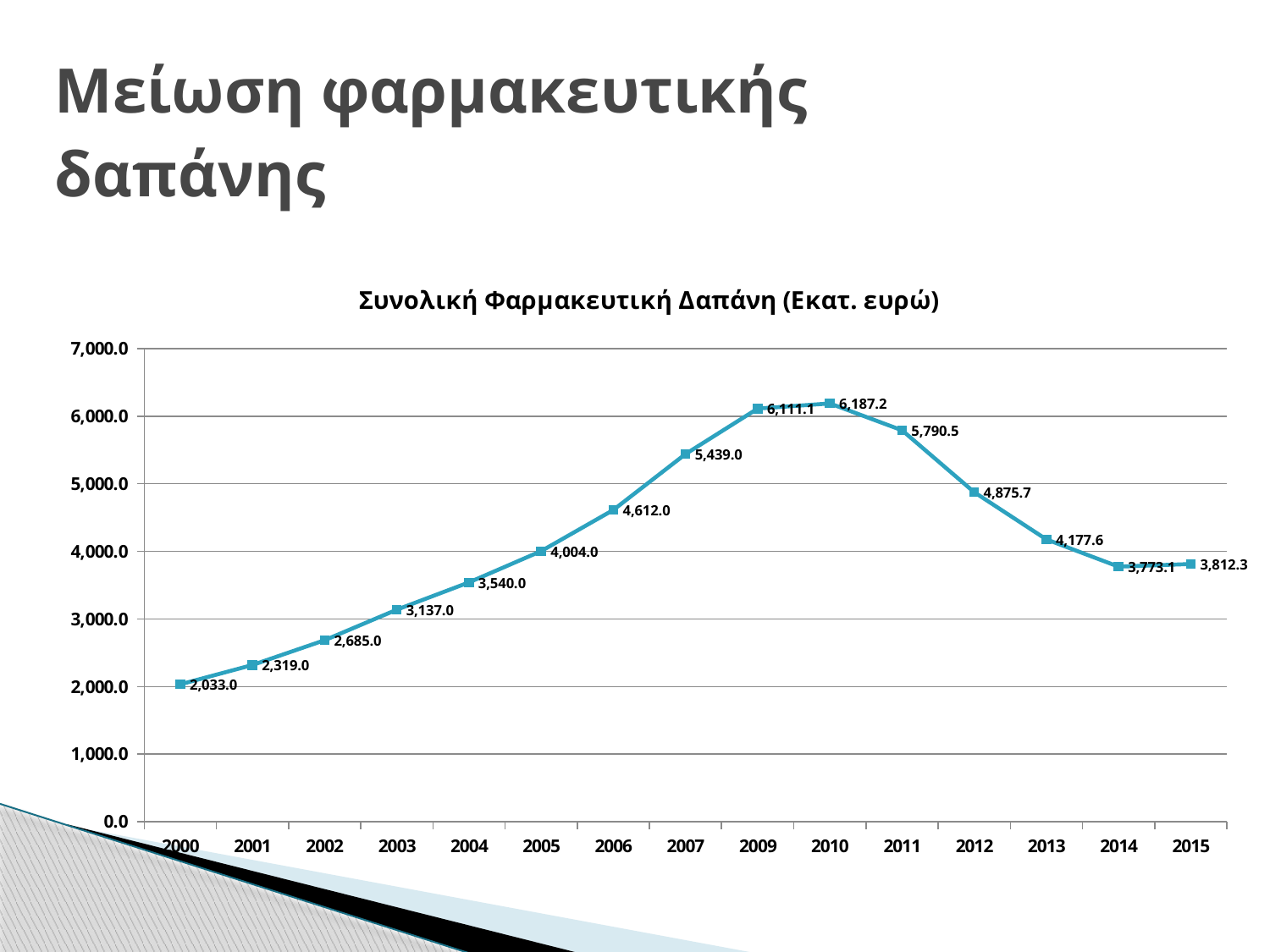
What is the value for 2015? 3,812.3 Is the value for 2013 greater or less than 4,000.0? greater Do the values rise or fall from 2010 to 2014? Fall Which is larger, the value for 2012 or the value for 2006? 2012 How many years are plotted on the x axis? 15 Which year has the highest value? 2010 What type of chart is shown on the slide? Line chart What is the title of the chart? Συνολική Φαρμακευτική Δαπάνη (Εκατ. ευρώ) What is the value for 2000? 2,033.0 Which year has the lowest value? 2000 What is the value for 2007? 5,439.0 What is the difference between the values for 2010 and 2015? 2,374.9